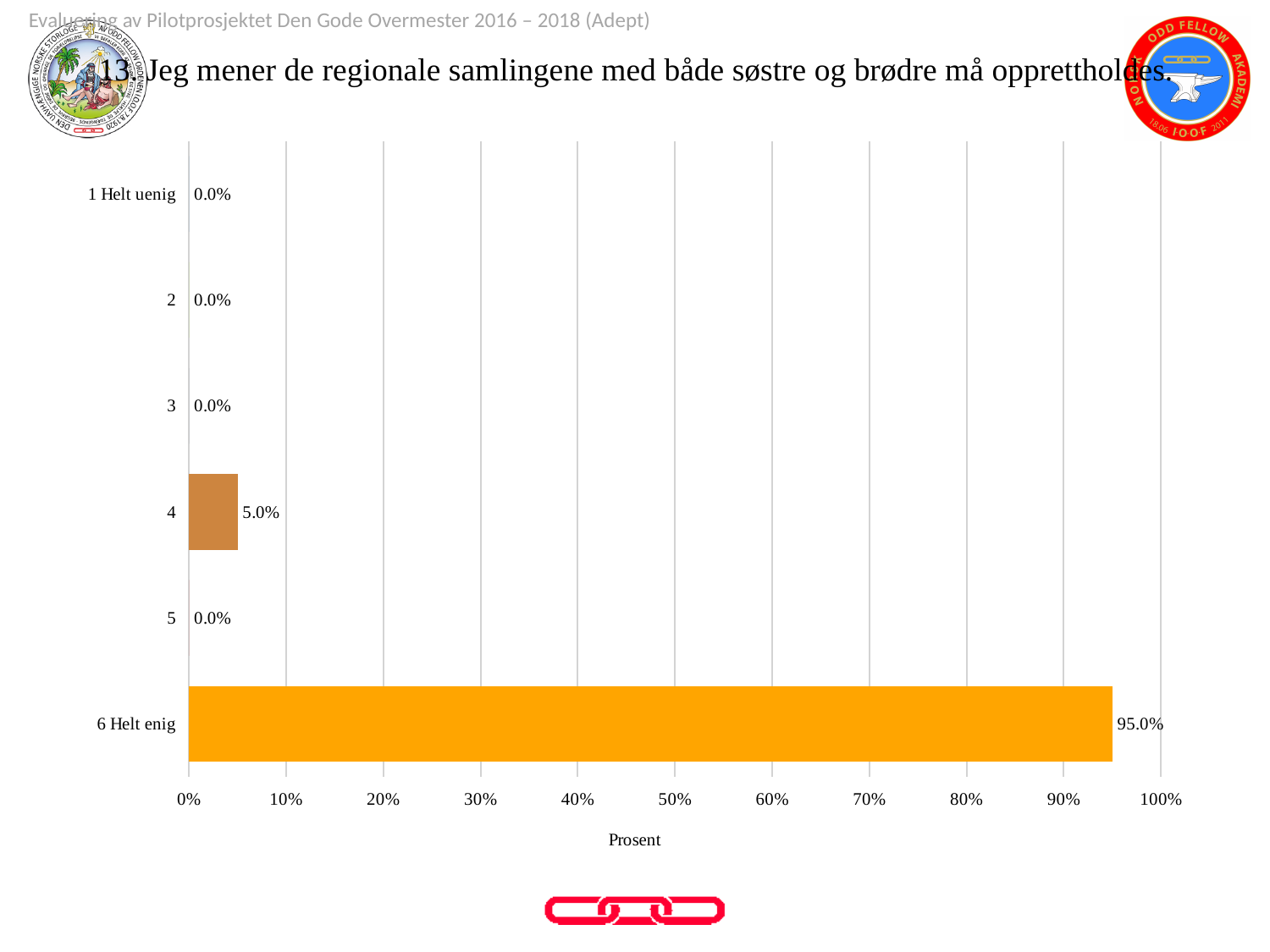
How many categories have a value of 0.0%? 4 Which is larger, the value for category 4 or the value for category 5? 4 What is the label of the horizontal axis? Prosent What is the difference between the values for "6 Helt enig" and category 4? 90.0% Which category has the highest value? 6 Helt enig What is the value for category 3? 0.0% What is the value for "6 Helt enig"? 95.0% What is the value for category 4? 5.0% How many categories are shown on the chart? 6 Is the value for "6 Helt enig" greater or less than 90%? greater What is the value for "1 Helt uenig"? 0.0% What kind of chart is shown on the slide? bar chart